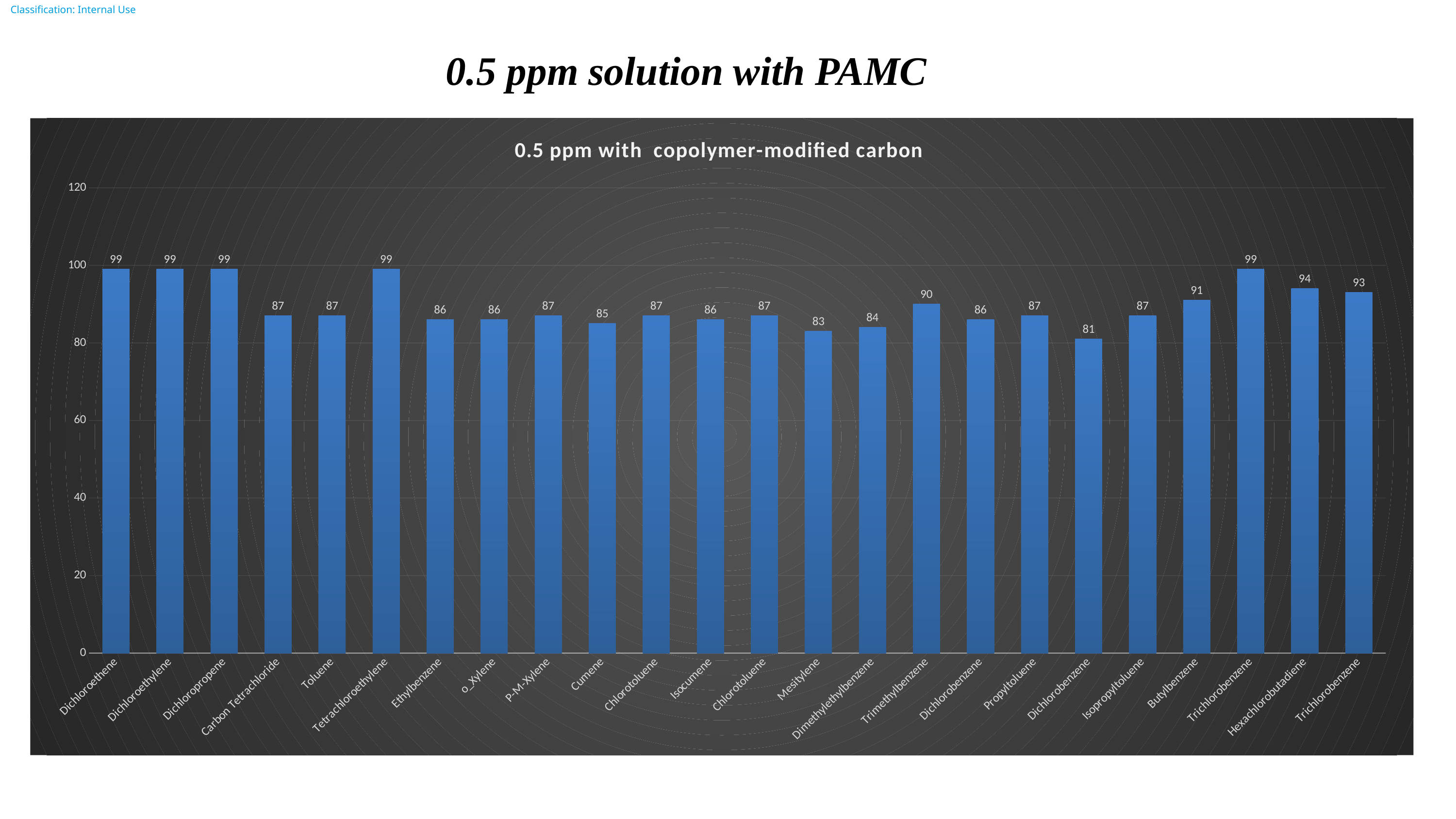
What is the title printed inside the chart area? 0.5 ppm with copolymer-modified carbon What is the difference between the values for Hexachlorobutadiene and Mesitylene? 11 What is the value for Hexachlorobutadiene? 94 Which is larger, the value for Trimethylbenzene or the value for Dimethylethylbenzene? Trimethylbenzene What kind of chart is shown on the slide? Bar chart What is the value for Cumene? 85 What is the lowest value shown in the chart? 81 How many categories (bars) are plotted in the chart? 24 What is the value for Mesitylene? 83 What is the value for Trimethylbenzene? 90 What is the value for Butylbenzene? 91 What is the highest value shown in the chart? 99